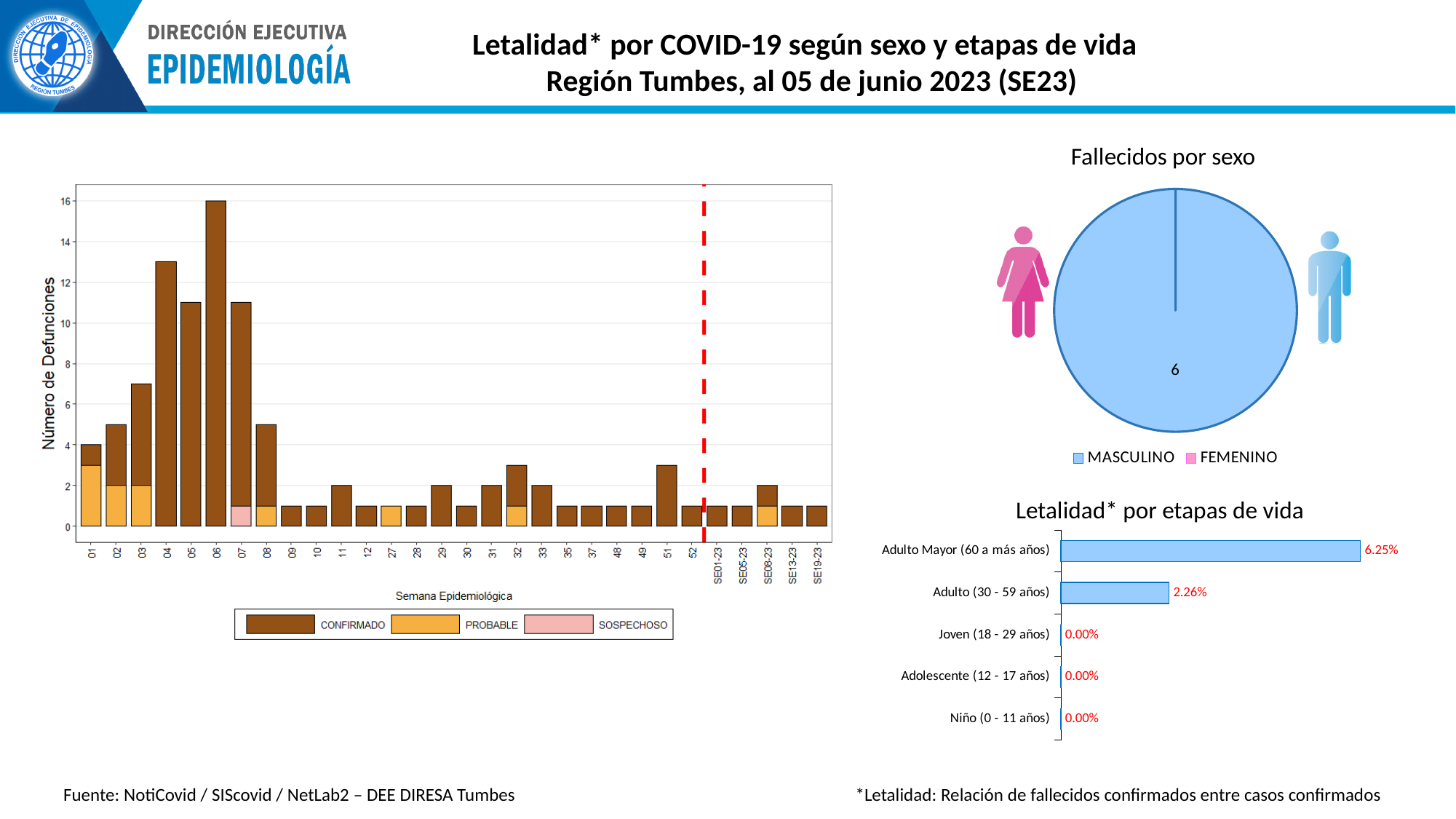
In the 'Letalidad* por etapas de vida' chart, which age group has the highest value? Adulto Mayor (60 a más años) In the 'Letalidad* por etapas de vida' chart, what is the difference between the values for Adulto Mayor (60 a más años) and Adulto (30 - 59 años)? 3.99% In the bar chart on the left, what is the number of deaths for week 06? 16 In the 'Letalidad* por etapas de vida' chart, what is the value for Adulto (30 - 59 años)? 2.26% In the 'Fallecidos por sexo' chart, what value is shown for MASCULINO? 6 How many age groups are shown in the 'Letalidad* por etapas de vida' chart? 5 In the bar chart on the left, is the value for week 04 greater or less than 12? greater What kind of chart is 'Letalidad* por etapas de vida'? Bar chart How many series does the legend of the 'Fallecidos por sexo' chart list? 2 How many series does the legend of the bar chart on the left list? 3 In the bar chart on the left, which epidemiological week has the highest number of deaths? 06 In the 'Letalidad* por etapas de vida' chart, what is the value for Adulto Mayor (60 a más años)? 6.25%